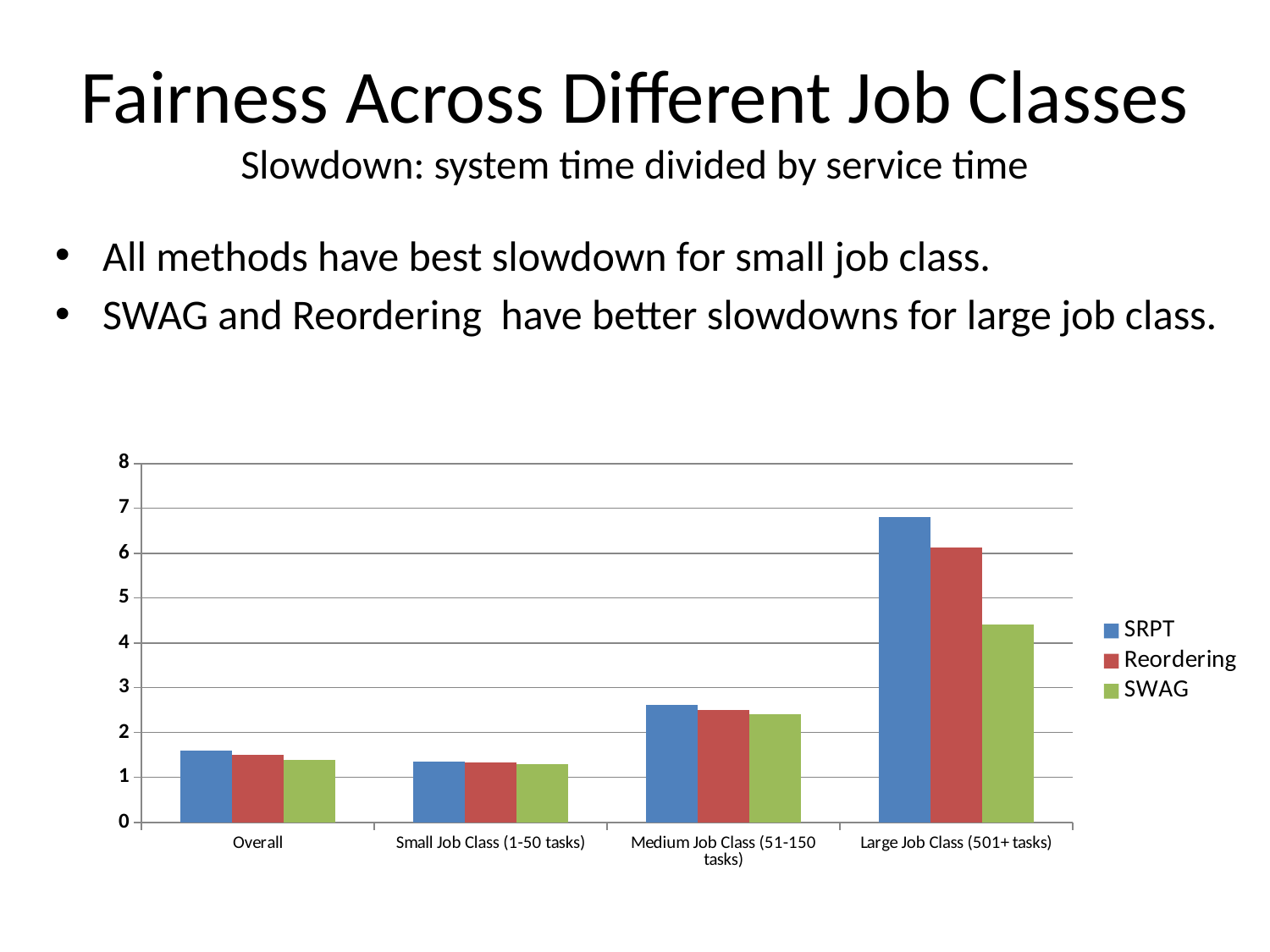
Is the SWAG value for Large Job Class (501+ tasks) greater or less than 5? less Which job class has the highest SRPT value? Large Job Class (501+ tasks) Which series has the lowest value in the Large Job Class (501+ tasks) category? SWAG Is the SWAG value for Small Job Class (1-50 tasks) greater or less than 2? less What colour represents the SWAG series in the chart? green How many series does the legend list? 3 How many job class categories are shown on the x axis? 4 Is the SRPT value for Medium Job Class (51-150 tasks) greater or less than 2? greater What kind of chart is shown on the slide? bar chart Which is larger: the SRPT value for Medium Job Class (51-150 tasks) or the SRPT value for Overall? Medium Job Class (51-150 tasks)